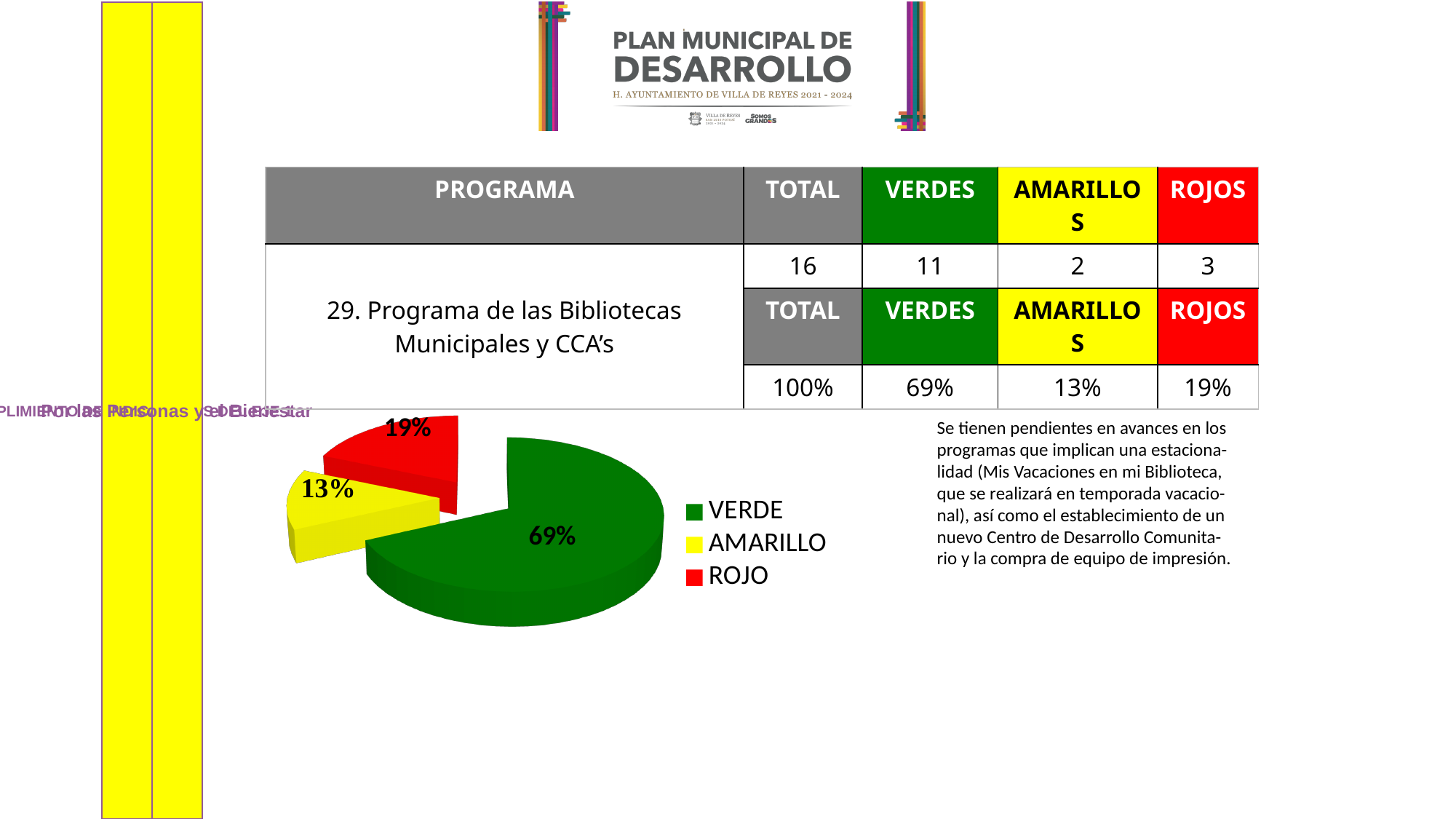
What percentage does the ROJO slice of the pie chart show? 19% Which is larger in the pie chart, ROJO or AMARILLO? ROJO How many slices does the pie chart have? 3 What colour is the ROJO slice in the pie chart? red Which slice of the pie chart is the largest? VERDE How many entries does the pie chart legend list? 3 What is the difference in percentage points between the ROJO and AMARILLO slices? 6 What percentage does the AMARILLO slice of the pie chart show? 13% What is the difference in percentage points between the VERDE and ROJO slices? 50 What percentage does the VERDE slice of the pie chart show? 69% Which slice of the pie chart is the smallest? AMARILLO What kind of chart is shown on the slide? pie chart